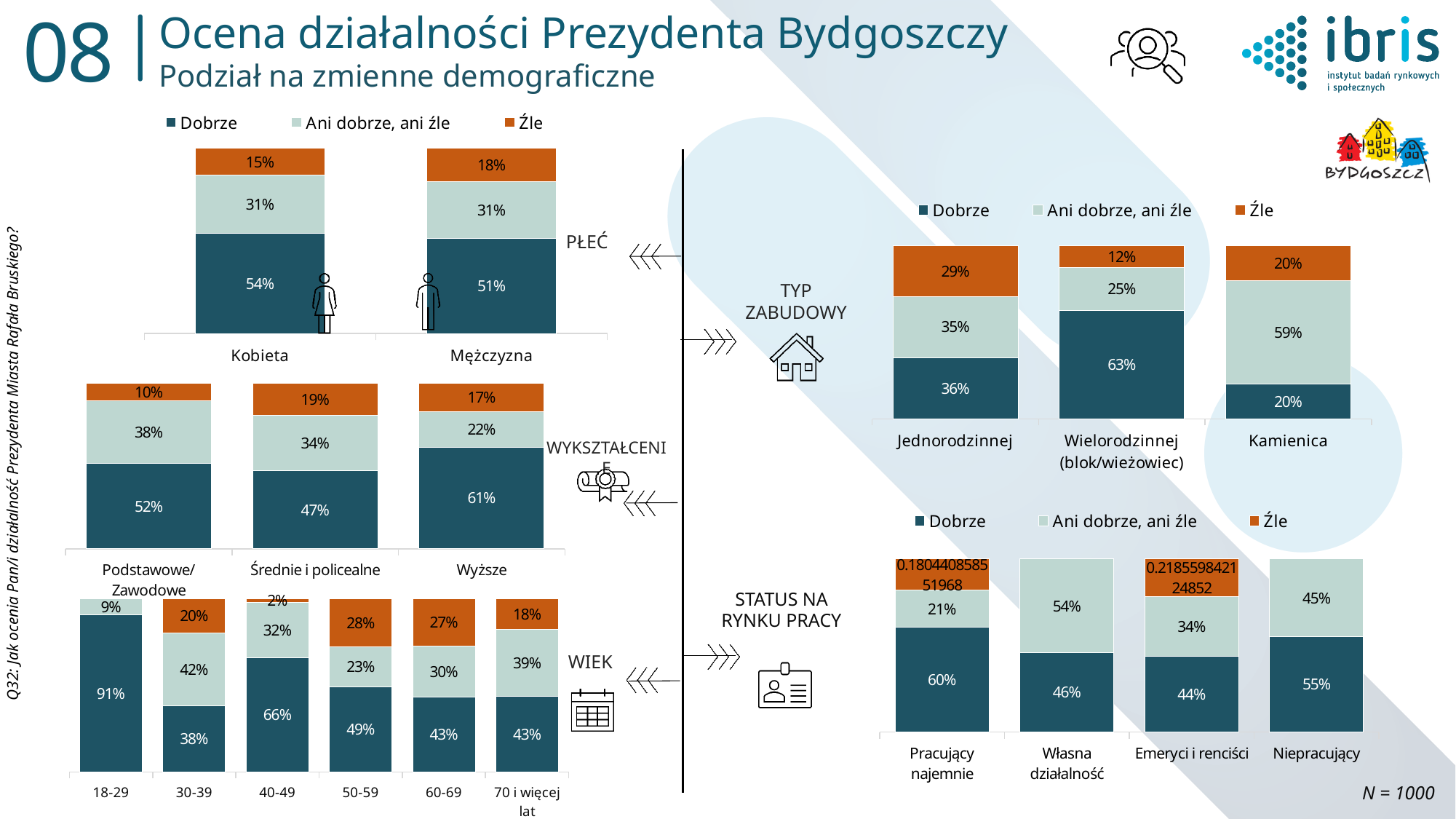
In the WYKSZTAŁCENIE (education) chart, which category has the highest 'Dobrze' value? Wyższe In the WYKSZTAŁCENIE (education) chart, what is the 'Ani dobrze, ani źle' value for Średnie i policealne? 34% How many age categories are shown in the WIEK (age) chart? 6 In the PŁEĆ (gender) chart, what percentage of women (Kobieta) rated the president 'Dobrze'? 54% In the WIEK (age) chart, what is the 'Źle' value for the 50-59 group? 28% In the TYP ZABUDOWY (building type) chart, which category has the lowest 'Dobrze' value? Kamienica In the PŁEĆ (gender) chart, what is the 'Źle' value for Mężczyzna? 18% How many series does the legend of the TYP ZABUDOWY (building type) chart list? 3 In the PŁEĆ (gender) chart, what is the difference between the 'Dobrze' values for Kobieta and Mężczyzna? 3 percentage points In the TYP ZABUDOWY (building type) chart, what is the 'Dobrze' value for Wielorodzinnej (blok/wieżowiec)? 63% In the WIEK (age) chart, which age group has the highest 'Dobrze' value? 18-29 In the STATUS NA RYNKU PRACY (labor market status) chart, is the 'Dobrze' value for Pracujący najemnie larger or smaller than for Emeryci i renciści? larger